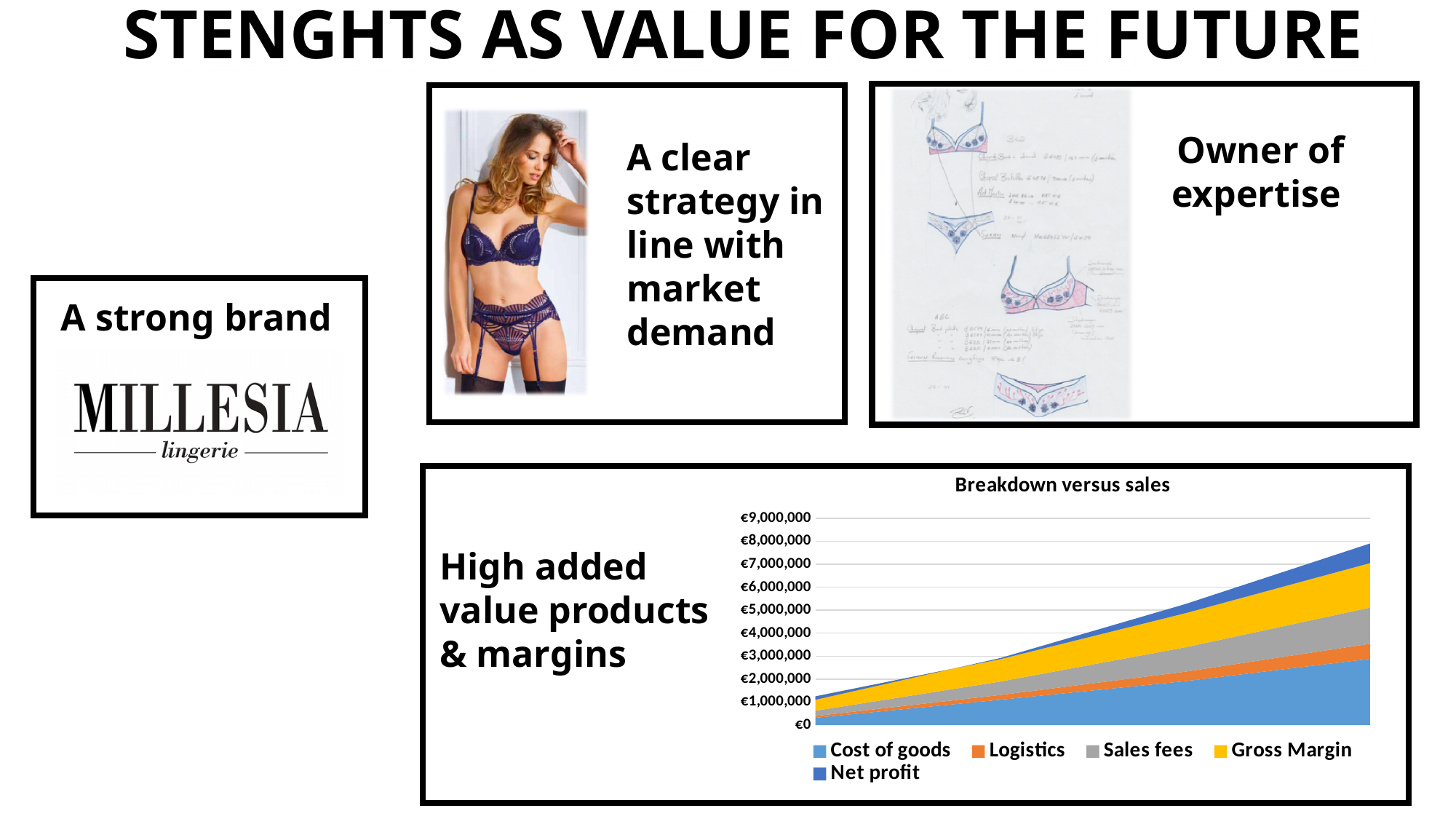
What is the title of the chart on the slide? Breakdown versus sales What is the highest value shown on the y axis of the "Breakdown versus sales" chart? €9,000,000 What kind of chart is shown under "High added value products & margins"? Stacked area chart In the "Breakdown versus sales" chart, which is larger at the right end: Cost of goods or Logistics? Cost of goods How many series does the legend of the "Breakdown versus sales" chart list? 5 In the "Breakdown versus sales" chart, do the stacked values rise or fall from left to right? Rise In the "Breakdown versus sales" chart, which series has the thickest band (largest values) at the right end? Cost of goods In the "Breakdown versus sales" chart, which series has the thinnest band (smallest values) at the right end? Logistics In the "Breakdown versus sales" chart, is the total stacked value at the left end greater or less than €2,000,000? less In the "Breakdown versus sales" chart, is the total stacked value at the right end greater or less than €7,000,000? greater In the "Breakdown versus sales" chart, is the total stacked value at the right end greater or less than €9,000,000? less